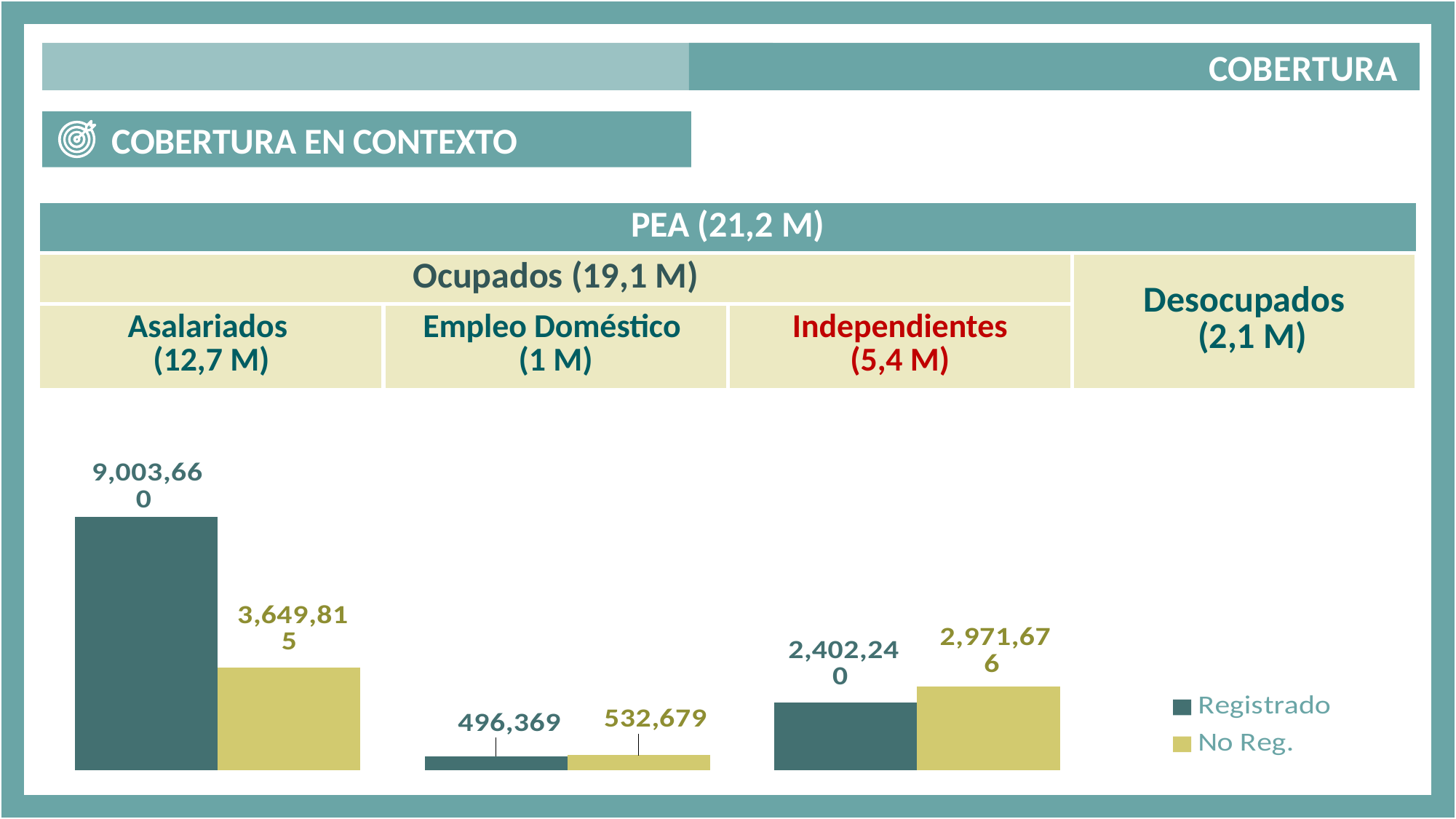
What is the No Reg. value for Independientes? 2,971,676 What are the two legend entries of the chart? Registrado and No Reg. What is the difference between the Registrado and No Reg. values for Asalariados? 5,353,845 For Independientes, which is larger: Registrado or No Reg.? No Reg. How many series does the legend list? 2 What is the Registrado value for Empleo Doméstico? 496,369 Which group has the highest Registrado value? Asalariados What is the difference between the No Reg. and Registrado values for Independientes? 569,436 Which group has the lowest No Reg. value? Empleo Doméstico What is the No Reg. value for Asalariados? 3,649,815 What is the Registrado value for Asalariados? 9,003,660 What kind of chart is shown on the slide? Bar chart